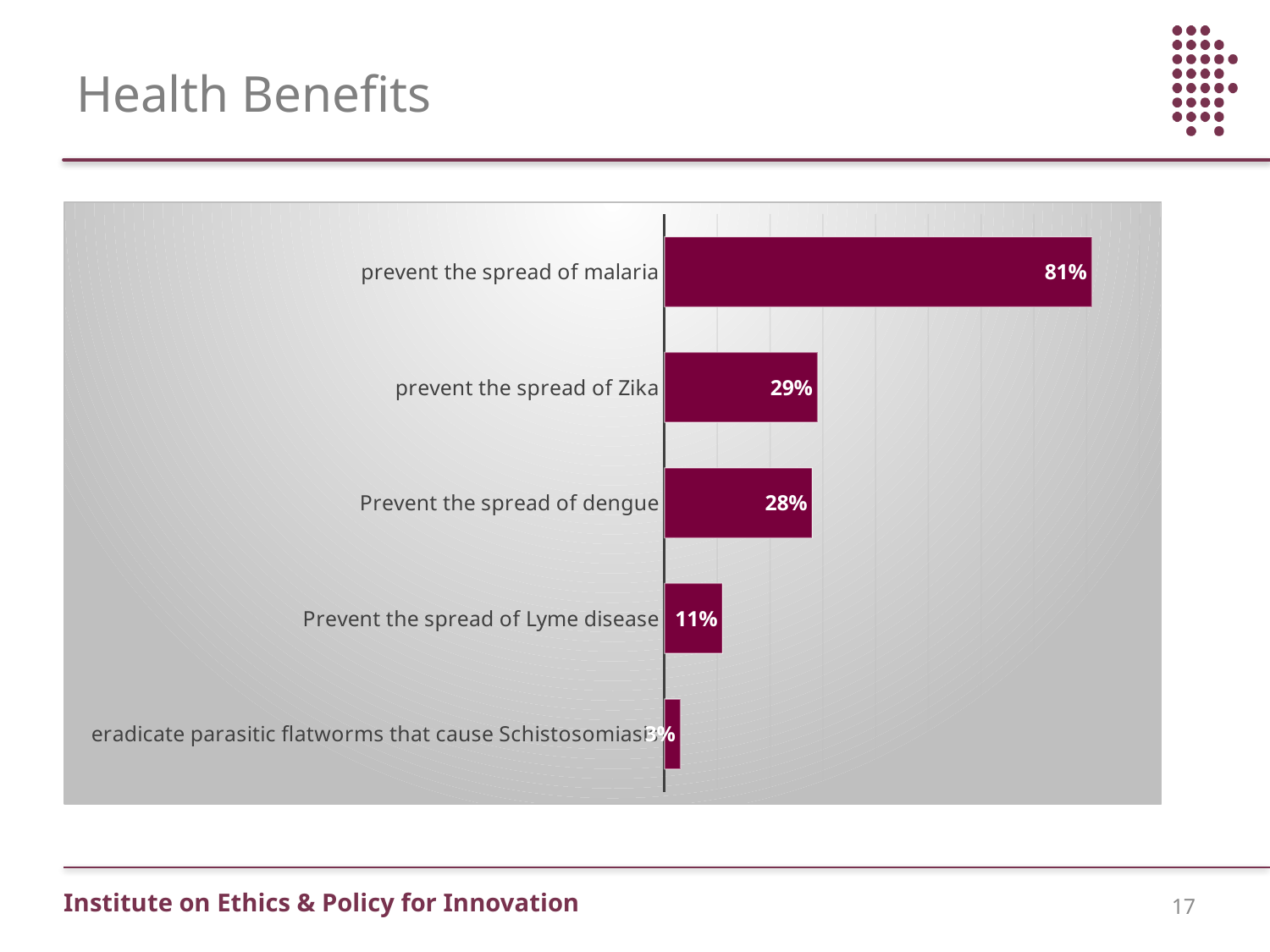
How many categories are shown in the chart? 5 Which category has the lowest value? eradicate parasitic flatworms that cause Schistosomiasis What percentage is shown for "prevent the spread of malaria"? 81% What kind of chart is shown on the slide? bar chart Which is larger, the value for "prevent the spread of malaria" or the value for "Prevent the spread of Lyme disease"? prevent the spread of malaria What percentage is shown for "Prevent the spread of Lyme disease"? 11% What percentage is shown for "prevent the spread of Zika"? 29% What percentage is shown for "Prevent the spread of dengue"? 28% What is the difference between the values for "Prevent the spread of dengue" and "Prevent the spread of Lyme disease"? 17% Which category has the highest value? prevent the spread of malaria What percentage is shown for "eradicate parasitic flatworms that cause Schistosomiasis"? 3% What is the difference between the values for "prevent the spread of malaria" and "prevent the spread of Zika"? 52%